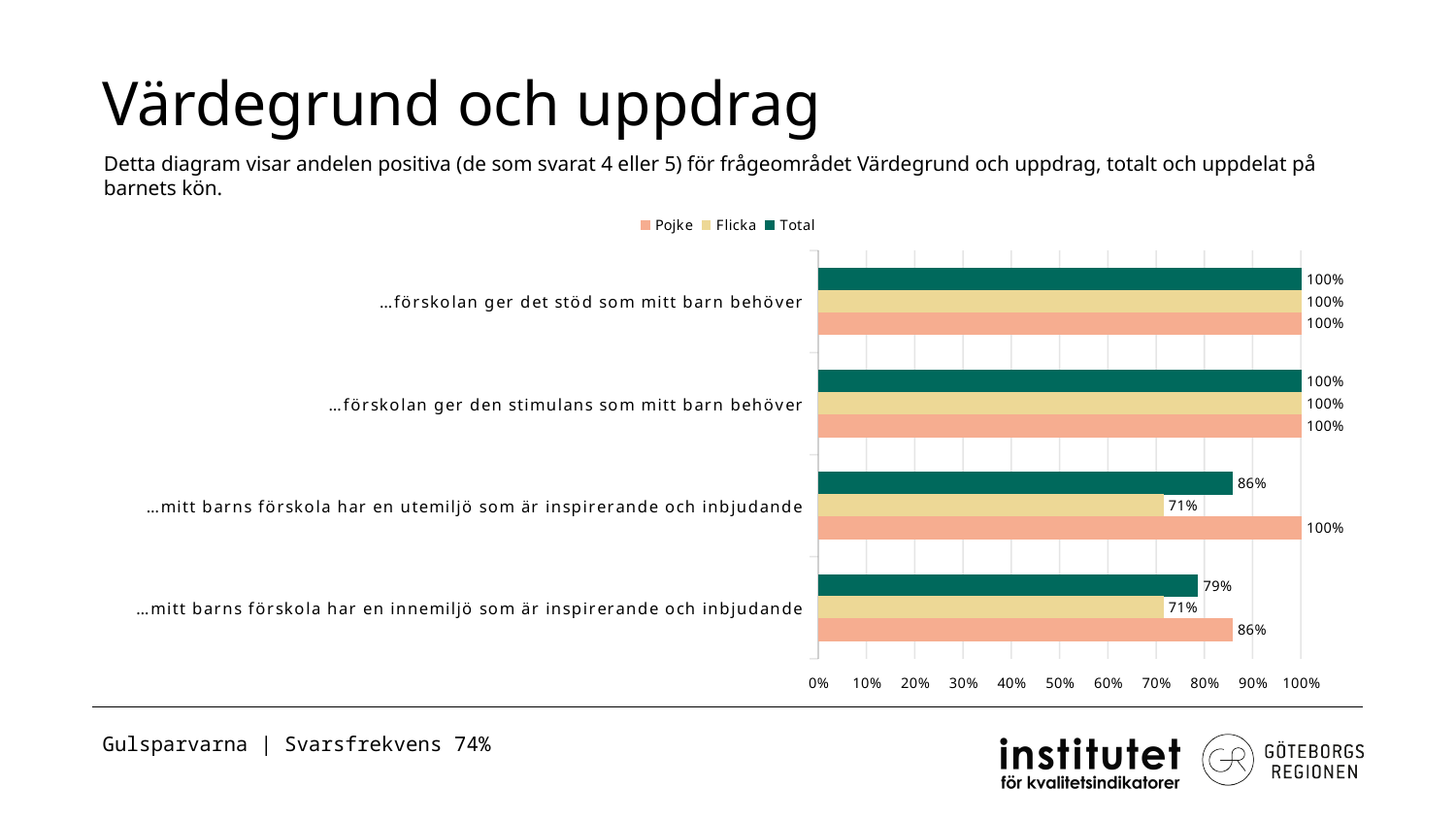
Which series is shown in green in the legend? Total What is the Total value for "…mitt barns förskola har en utemiljö som är inspirerande och inbjudande"? 86% How many categories are shown on the chart? 4 What is the Flicka value for "…mitt barns förskola har en innemiljö som är inspirerande och inbjudande"? 71% For "…mitt barns förskola har en utemiljö som är inspirerande och inbjudande", which is larger, the Pojke value or the Flicka value? Pojke What is the Pojke value for "…mitt barns förskola har en innemiljö som är inspirerande och inbjudande"? 86% What is the difference between the Pojke and Total values for "…mitt barns förskola har en innemiljö som är inspirerande och inbjudande"? 7 percentage points Which category has the lowest Total value? …mitt barns förskola har en innemiljö som är inspirerande och inbjudande What is the Total value for "…förskolan ger den stimulans som mitt barn behöver"? 100% How many series does the legend list? 3 What is the difference between the Pojke and Flicka values for "…mitt barns förskola har en utemiljö som är inspirerande och inbjudande"? 29 percentage points What kind of chart is shown on the slide? Bar chart